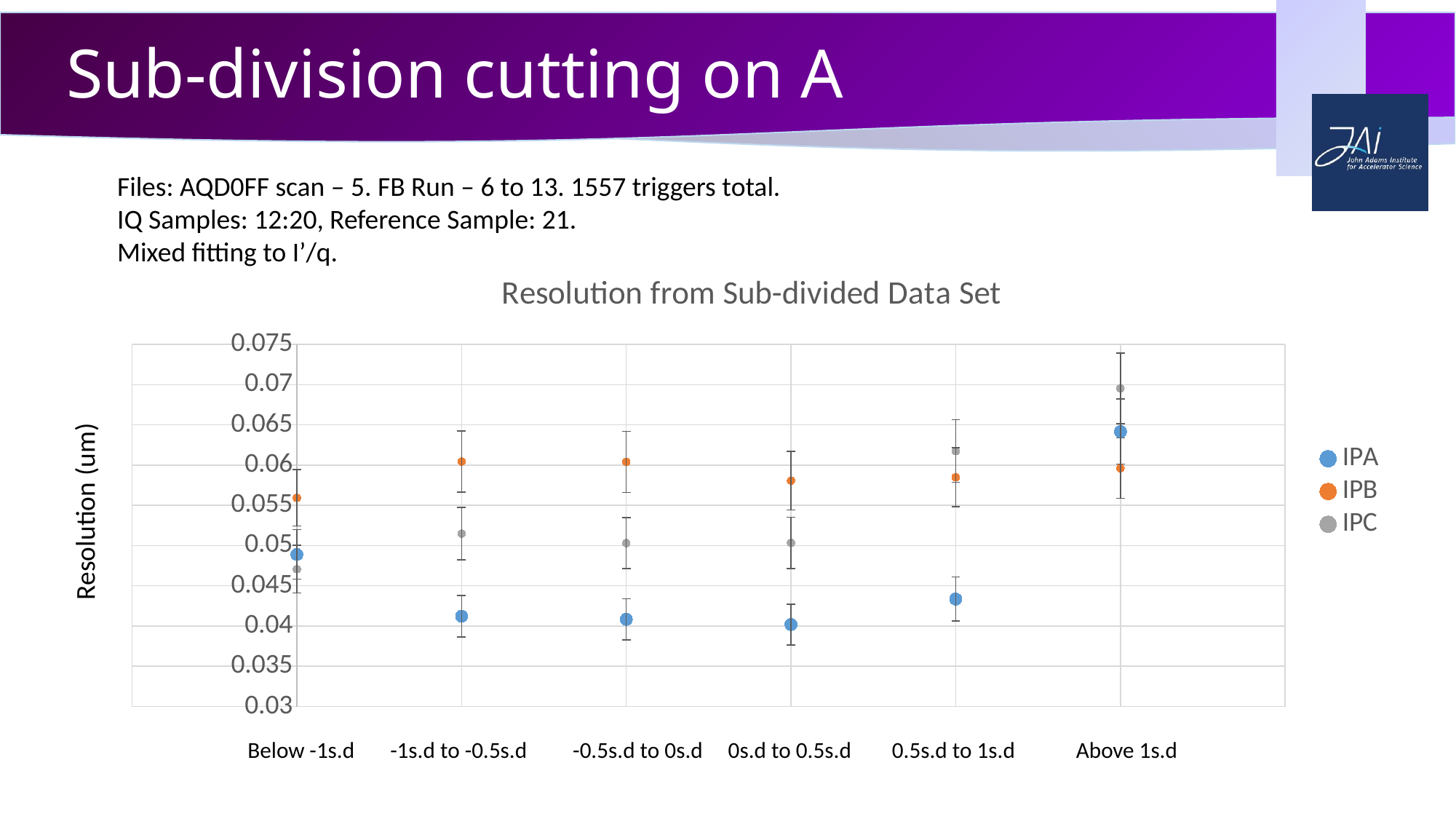
Is the IPB value for -1s.d to -0.5s.d greater or less than 0.055? greater How many series does the legend list? 3 At Below -1s.d, which series has the larger value, IPA or IPB? IPB Is the IPC value for Above 1s.d greater or less than 0.065? greater At Above 1s.d, which series has the larger value, IPB or IPC? IPC How many categories are shown along the x axis? 6 Is the IPA value for 0s.d to 0.5s.d greater or less than 0.045? less For the IPC series, which category has the highest resolution? Above 1s.d For the IPC series, which category has the lowest resolution? Below -1s.d For the IPA series, which category has the highest resolution? Above 1s.d What is the title of the chart? Resolution from Sub-divided Data Set What kind of chart is shown on the slide? scatter chart